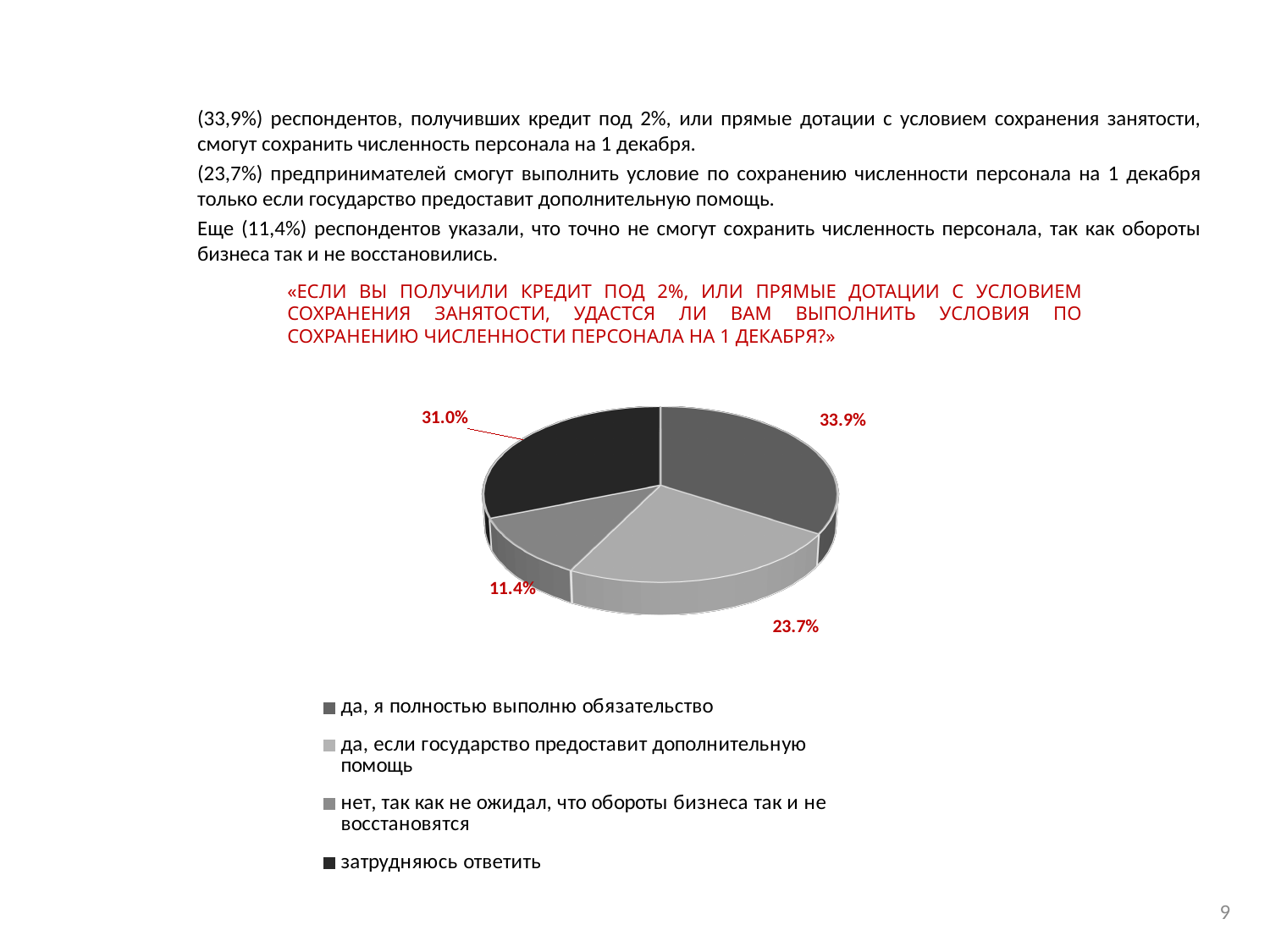
What is the difference in percentage points between the "да, я полностью выполню обязательство" slice and the "затрудняюсь ответить" slice? 2.9 How many slices does the pie chart have? 4 What share of respondents answered "да, если государство предоставит дополнительную помощь"? 23.7% Which is larger: the share for "да, если государство предоставит дополнительную помощь" or the share for "затрудняюсь ответить"? затрудняюсь ответить What is the combined share of the two "да" answer options? 57.6% Which answer option has the largest slice of the pie? да, я полностью выполню обязательство What share of respondents answered "нет, так как не ожидал, что обороты бизнеса так и не восстановятся"? 11.4% Which answer option has the smallest slice of the pie? нет, так как не ожидал, что обороты бизнеса так и не восстановятся How many entries does the legend list? 4 What share of respondents answered "затрудняюсь ответить"? 31.0% What share of respondents answered "да, я полностью выполню обязательство"? 33.9% What kind of chart is shown on the slide? pie chart